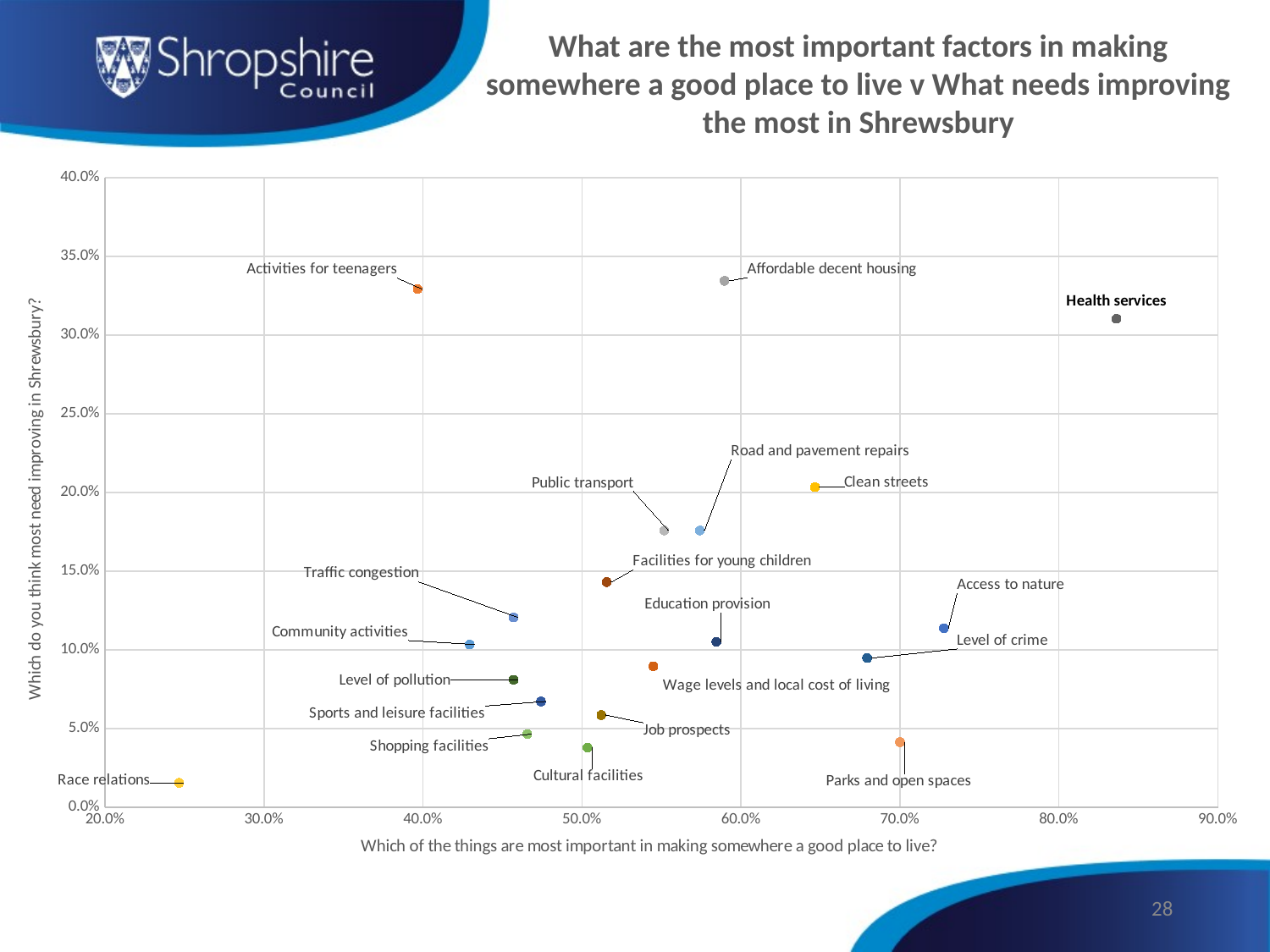
Which factor has the lowest value on the horizontal axis? Race relations Is the vertical-axis value for Parks and open spaces greater or less than 5.0%? less Is the horizontal-axis value for Activities for teenagers greater or less than 45.0%? less Which factor has the highest value on the horizontal axis (most important in making somewhere a good place to live)? Health services Which factor has the lowest value on the vertical axis (most need improving in Shrewsbury)? Race relations Is the vertical-axis value for Affordable decent housing greater or less than 30.0%? greater Which has the higher vertical-axis value, Clean streets or Parks and open spaces? Clean streets How many factors are plotted as points on the chart? 20 Which has the higher horizontal-axis value, Access to nature or Level of crime? Access to nature What kind of chart is shown on the slide? Scatter chart What is the title of the horizontal axis? Which of the things are most important in making somewhere a good place to live?